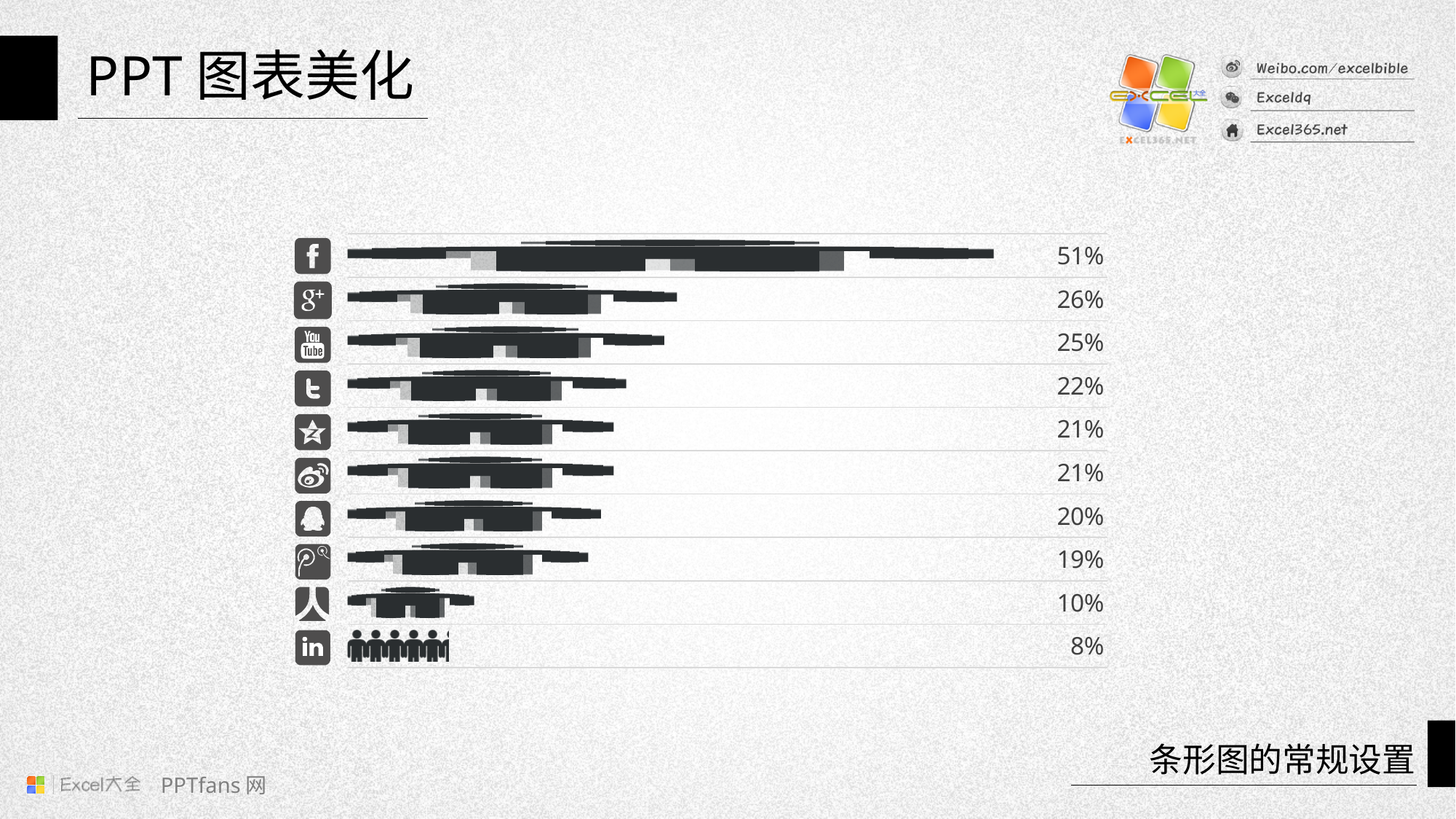
What value is shown for the Google+ bar? 26% What value is shown for the LinkedIn bar? 8% What kind of chart is shown on the slide? Bar chart What is the difference between the Renren (人 icon) value and the LinkedIn value? 2% What value is shown for the Twitter bar? 22% What value is shown for the Facebook bar? 51% Do the values increase or decrease going from the top bar to the bottom bar? Decrease Which category has the lowest value in the chart? LinkedIn How many bars (categories) are shown in the chart? 10 Which category has the highest value in the chart? Facebook Which is larger, the YouTube value or the Twitter value? YouTube What is the difference between the Facebook value and the Google+ value? 25%